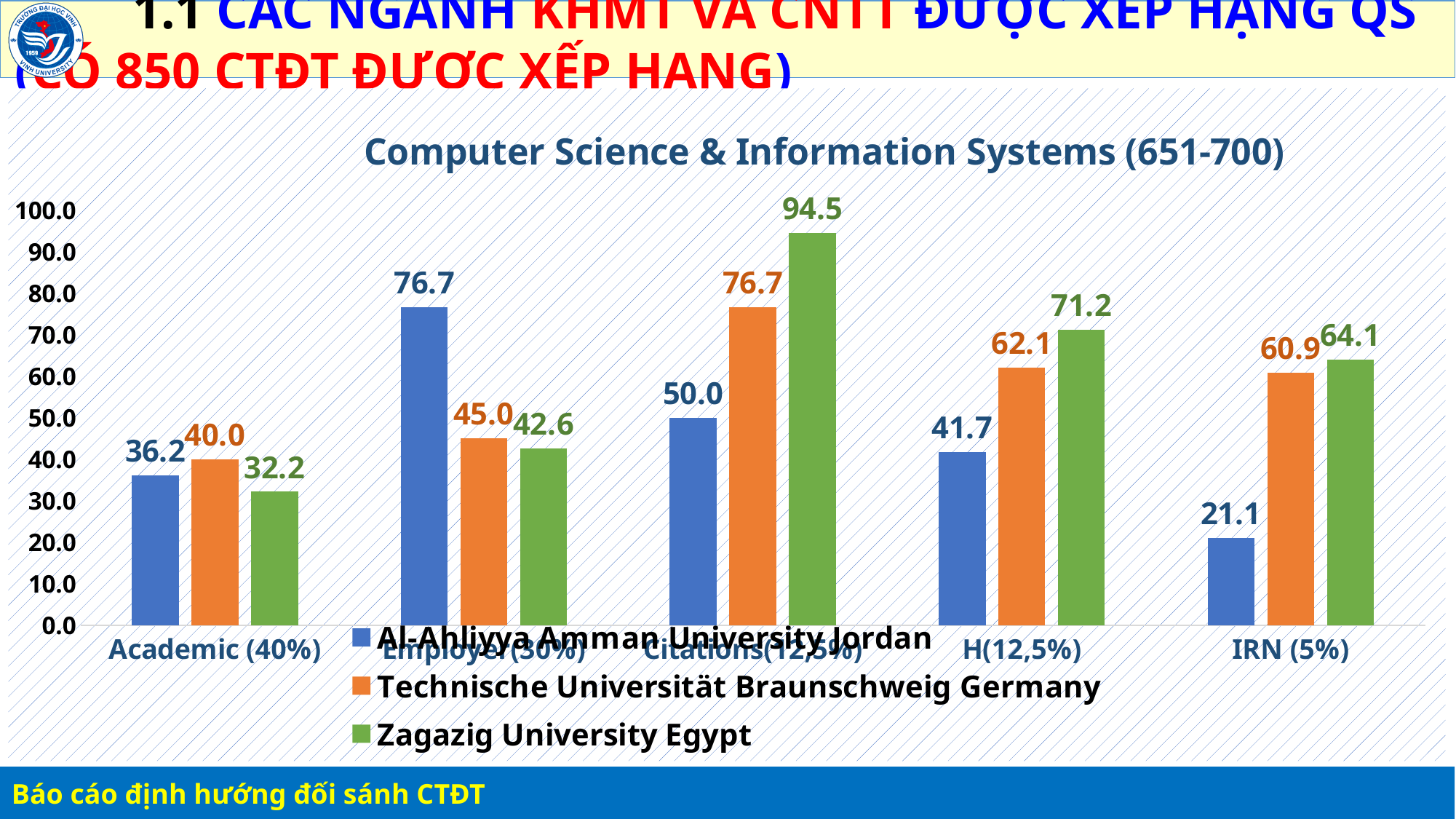
What is the value for Al-Ahliyya Amman University Jordan in the Academic (40%) category? 36.2 What is the title of the chart? Computer Science & Information Systems (651-700) What is the value for Zagazig University Egypt in the IRN (5%) category? 64.1 How many categories are shown on the x axis? 5 Which colour represents Technische Universität Braunschweig Germany in the chart? orange What is the difference between the Zagazig University Egypt and Al-Ahliyya Amman University Jordan values in the H(12,5%) category? 29.5 In the Employer (30%) category, which is larger: the value for Al-Ahliyya Amman University Jordan or for Technische Universität Braunschweig Germany? Al-Ahliyya Amman University Jordan What is the value for Technische Universität Braunschweig Germany in the H(12,5%) category? 62.1 How many series does the legend list? 3 In which category does Al-Ahliyya Amman University Jordan have its lowest value? IRN (5%) Which series has the highest value in the Citations(12,5%) category? Zagazig University Egypt What type of chart is shown on the slide? bar chart